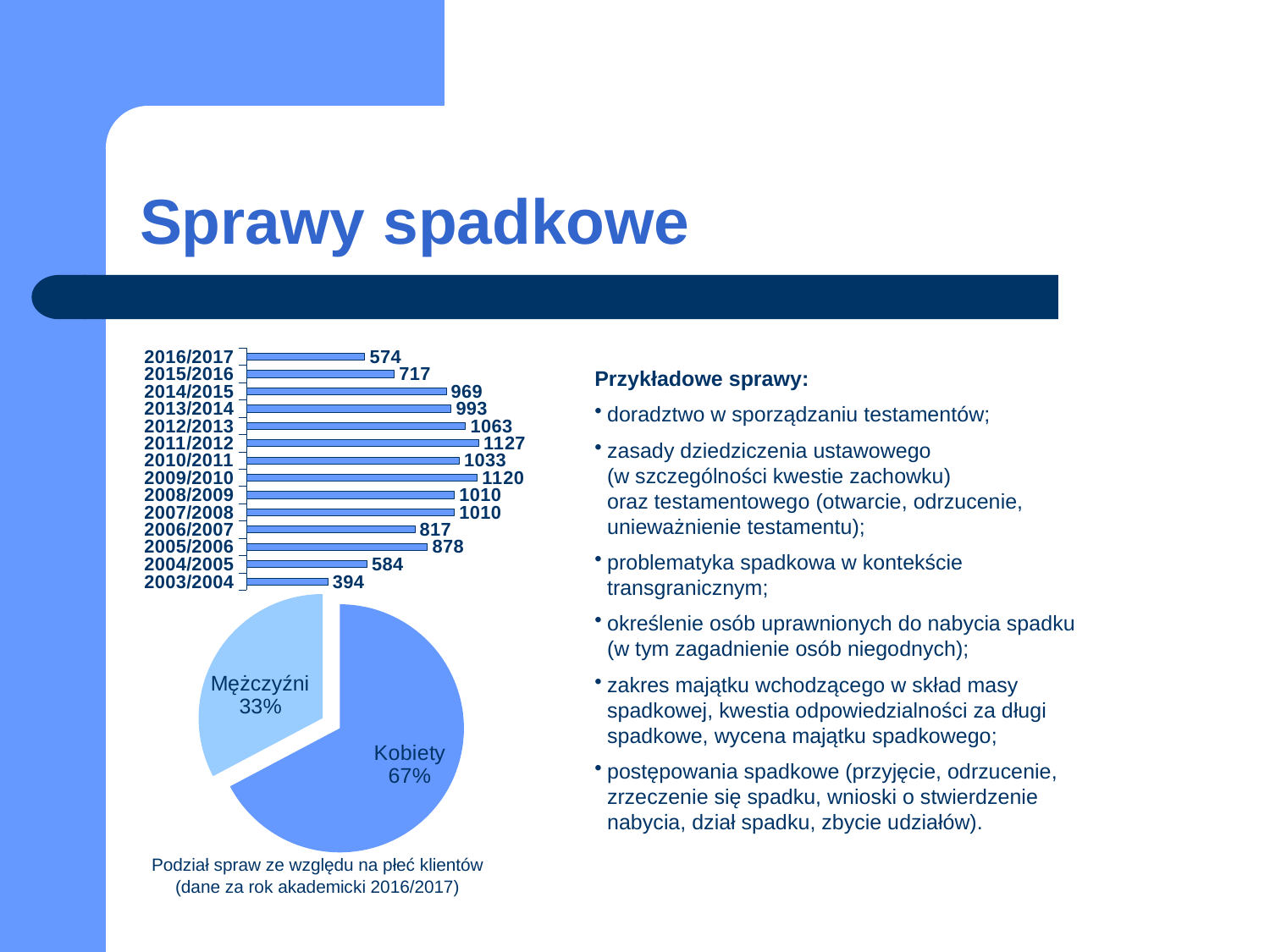
What kind of chart is the chart at the top left of the slide? bar chart In the pie chart titled 'Podział spraw ze względu na płeć klientów', what share is Mężczyźni? 33% What kind of chart is the chart at the bottom left of the slide? pie chart In the bar chart at the top left of the slide, what is the value for 2016/2017? 574 In the bar chart at the top left of the slide, what is the value for 2003/2004? 394 How many years (categories) are shown in the bar chart at the top left of the slide? 14 In the bar chart at the top left of the slide, which is larger, the value for 2012/2013 or the value for 2010/2011? 2012/2013 In the bar chart at the top left of the slide, what is the value for 2009/2010? 1120 In the bar chart at the top left of the slide, what is the difference between the values for 2015/2016 and 2016/2017? 143 In the bar chart at the top left of the slide, which year has the highest value? 2011/2012 In the pie chart titled 'Podział spraw ze względu na płeć klientów', what share is Kobiety? 67% In the bar chart at the top left of the slide, which year has the lowest value? 2003/2004